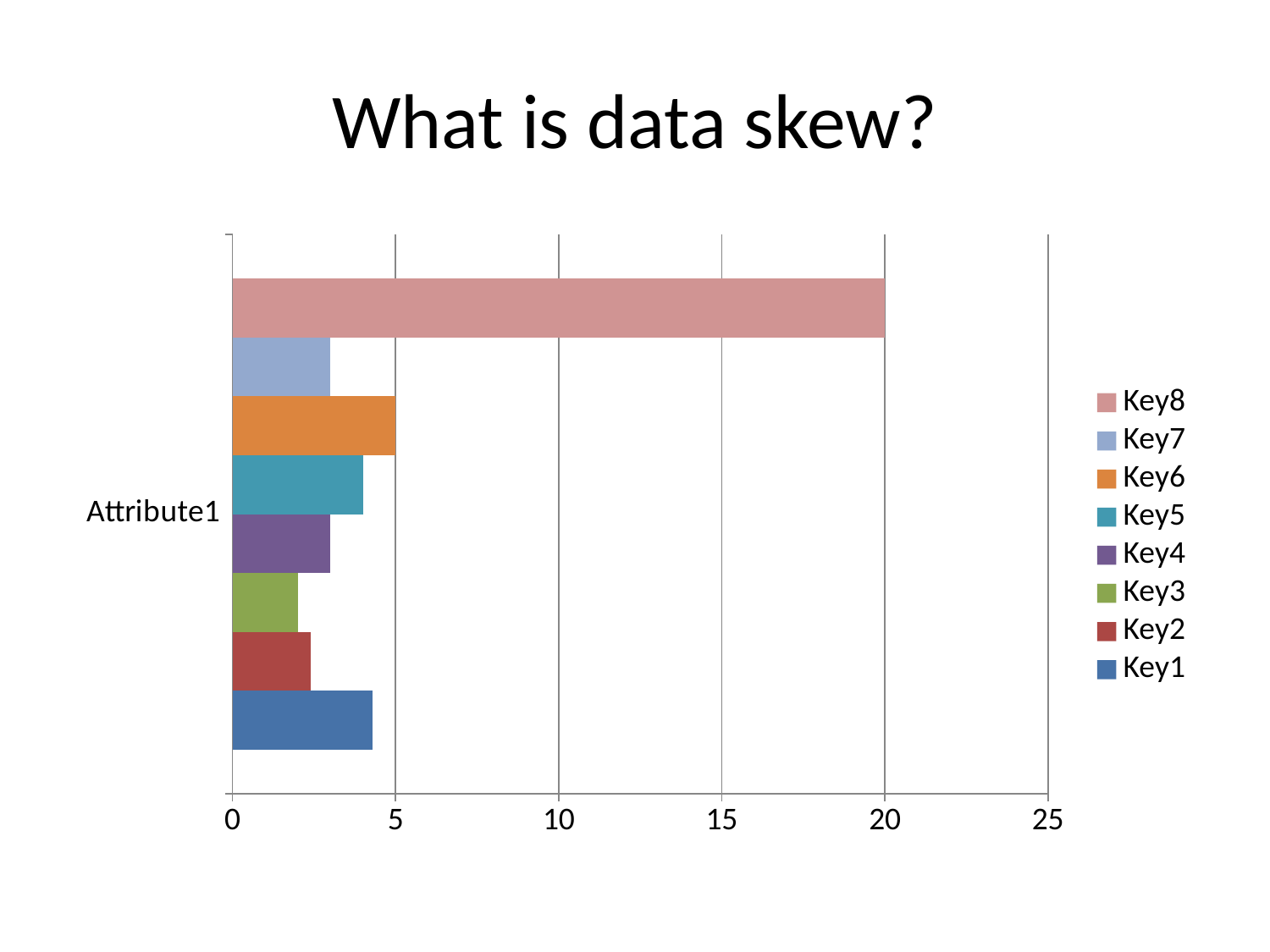
What is the value for Key8 on the chart? 20 Which is larger, the value for Key8 or the value for Key6? Key8 Is the value for Key8 greater or less than 15? greater What is the value for Key6 on the chart? 5 What kind of chart is shown on the slide? bar chart Is the value for Key1 greater or less than 5? less How many series does the legend list? 8 How many categories are shown on the vertical axis? 1 What is the difference between the values for Key8 and Key6? 15 What is the title of the slide? What is data skew? Is the value for Key7 greater or less than 5? less Which series has the highest value on the chart? Key8